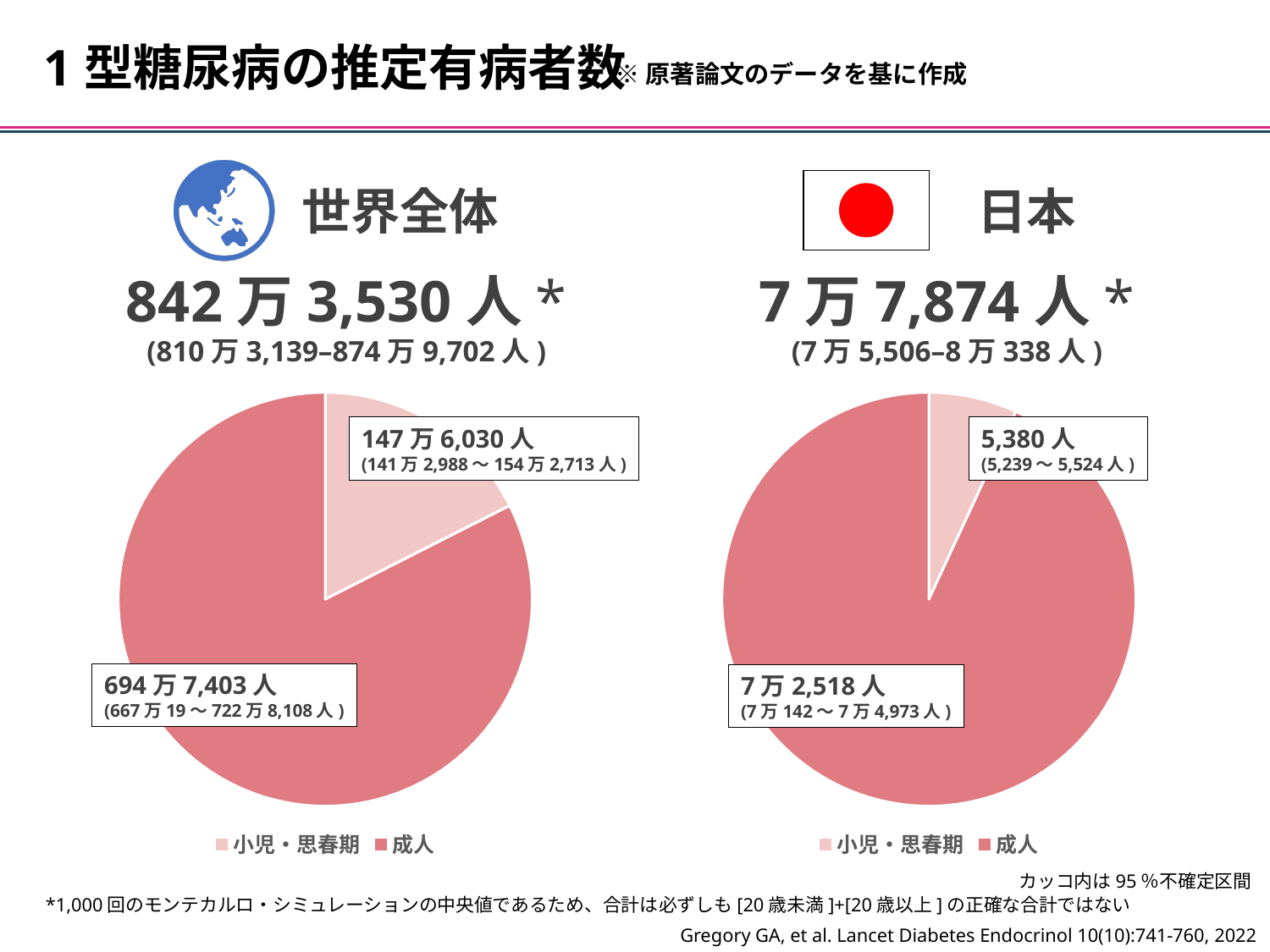
In the 日本 pie chart, which category has the smallest slice? 小児・思春期 In the 世界全体 pie chart, what is the difference between the 成人 value and the 小児・思春期 value? 547万1,373人 How many entries does the legend of the 世界全体 chart list? 2 In the 日本 pie chart, what is the difference between the 成人 value and the 小児・思春期 value? 6万7,138人 How many slices does the 世界全体 pie chart have? 2 What kind of chart is used for 日本? Pie chart In the 世界全体 pie chart, which category has the largest slice? 成人 In the 世界全体 pie chart, what is the value for 小児・思春期? 147万6,030人 In the 日本 pie chart, what is the value for 小児・思春期? 5,380人 In the 日本 pie chart, what is the value for 成人? 7万2,518人 In the 世界全体 pie chart, what is the value for 成人? 694万7,403人 In the 日本 pie chart, which is larger, 小児・思春期 or 成人? 成人